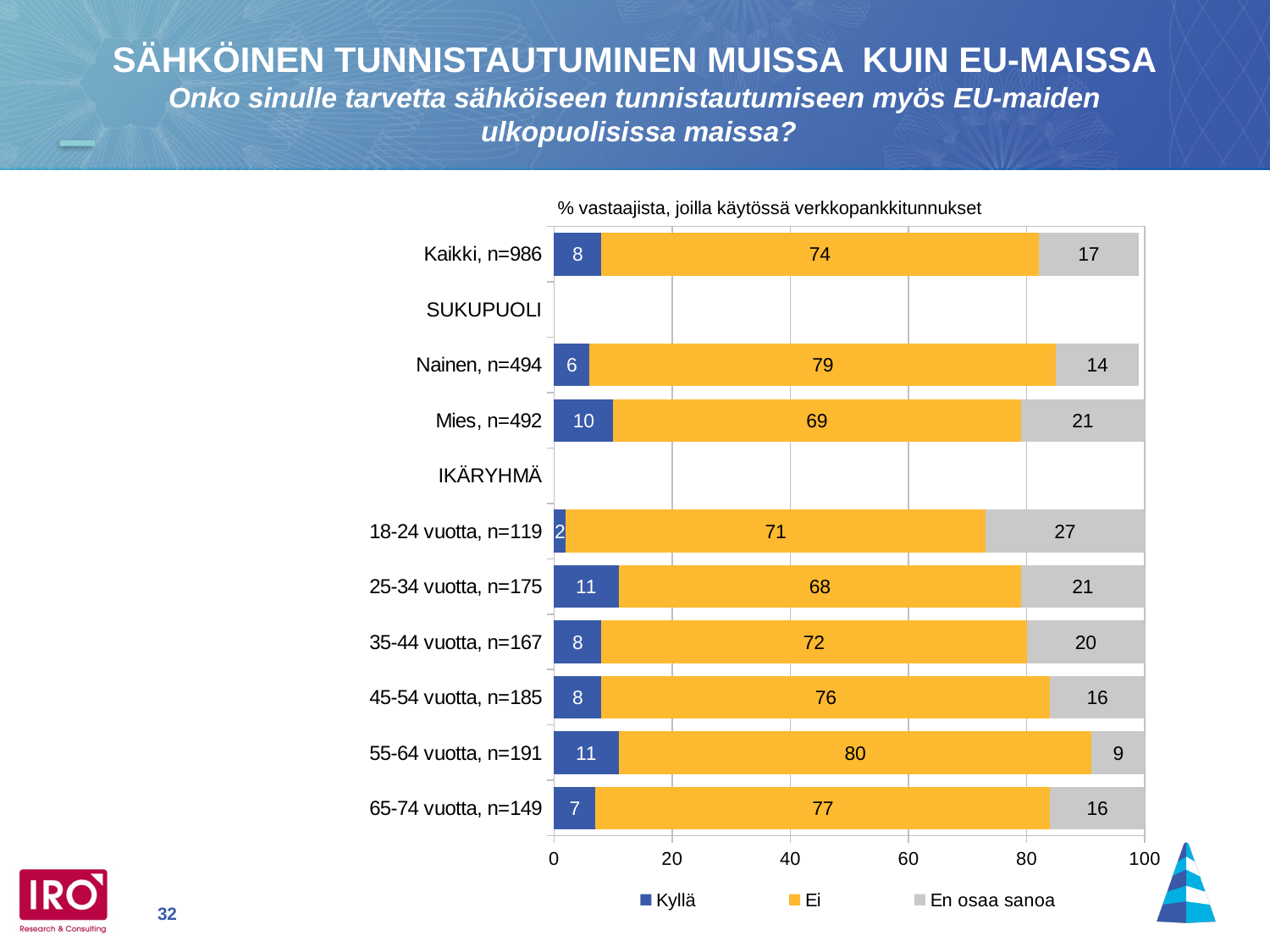
What is the difference between the "Ei" values for Nainen, n=494 and Mies, n=492? 10 What kind of chart is shown on the slide? Stacked bar chart What is the "Ei" value for Kaikki, n=986? 74 Which category has the lowest "Kyllä" value? 18-24 vuotta, n=119 What is the total of the stacked bar for 55-64 vuotta, n=191? 100 What is the "En osaa sanoa" value for 18-24 vuotta, n=119? 27 What is the subtitle text shown above the chart? % vastaajista, joilla käytössä verkkopankkitunnukset What is the "En osaa sanoa" value for 55-64 vuotta, n=191? 9 What is the "Kyllä" value for Mies, n=492? 10 Which is larger: the "En osaa sanoa" value for Mies, n=492 or for Nainen, n=494? Mies, n=492 How many series does the legend list? 3 Which category has the highest "Ei" value? 55-64 vuotta, n=191